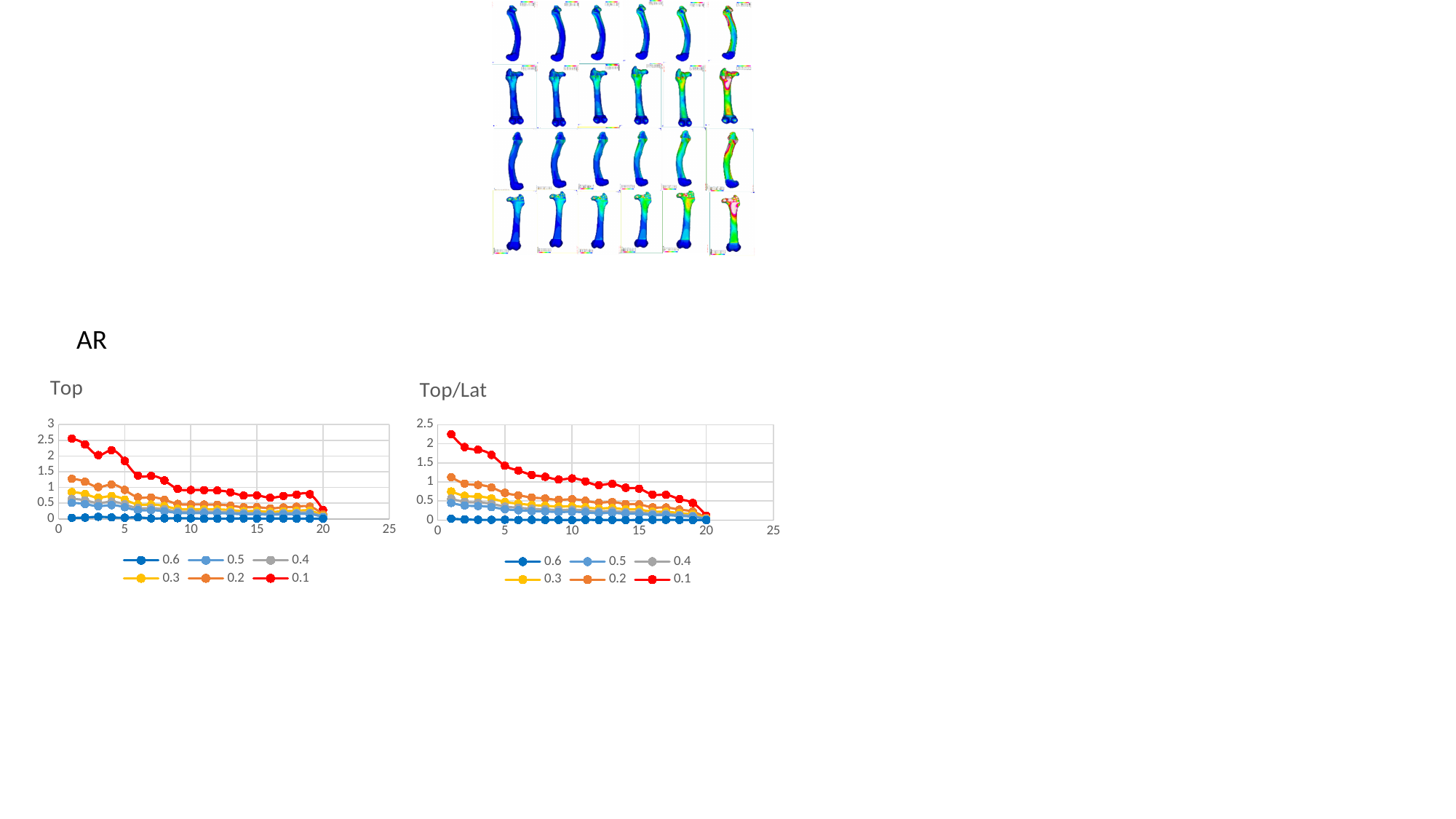
In the "Top" chart, do the values of the 0.1 series rise or fall as x increases? fall In the "Top" chart, which series has the highest values across the x axis? 0.1 In the "Top/Lat" chart, is the value of the 0.1 series at x = 1 greater or less than 2? greater In the "Top/Lat" chart, which series has the lowest values across the x axis? 0.6 What is the title of the chart on the right? Top/Lat In the "Top/Lat" chart, is the value of the 0.2 series at x = 1 greater or less than 1.5? less In the "Top" chart, is the value of the 0.1 series at x = 1 greater or less than 2? greater In the "Top/Lat" chart, do the values of the 0.2 series rise or fall as x increases? fall In the "Top" chart, what colour is the line for the 0.1 series? red What kind of chart is the "Top" chart? line chart How many series does the legend of the "Top/Lat" chart list? 6 In the "Top" chart, at x = 1, which series has the larger value, 0.1 or 0.2? 0.1